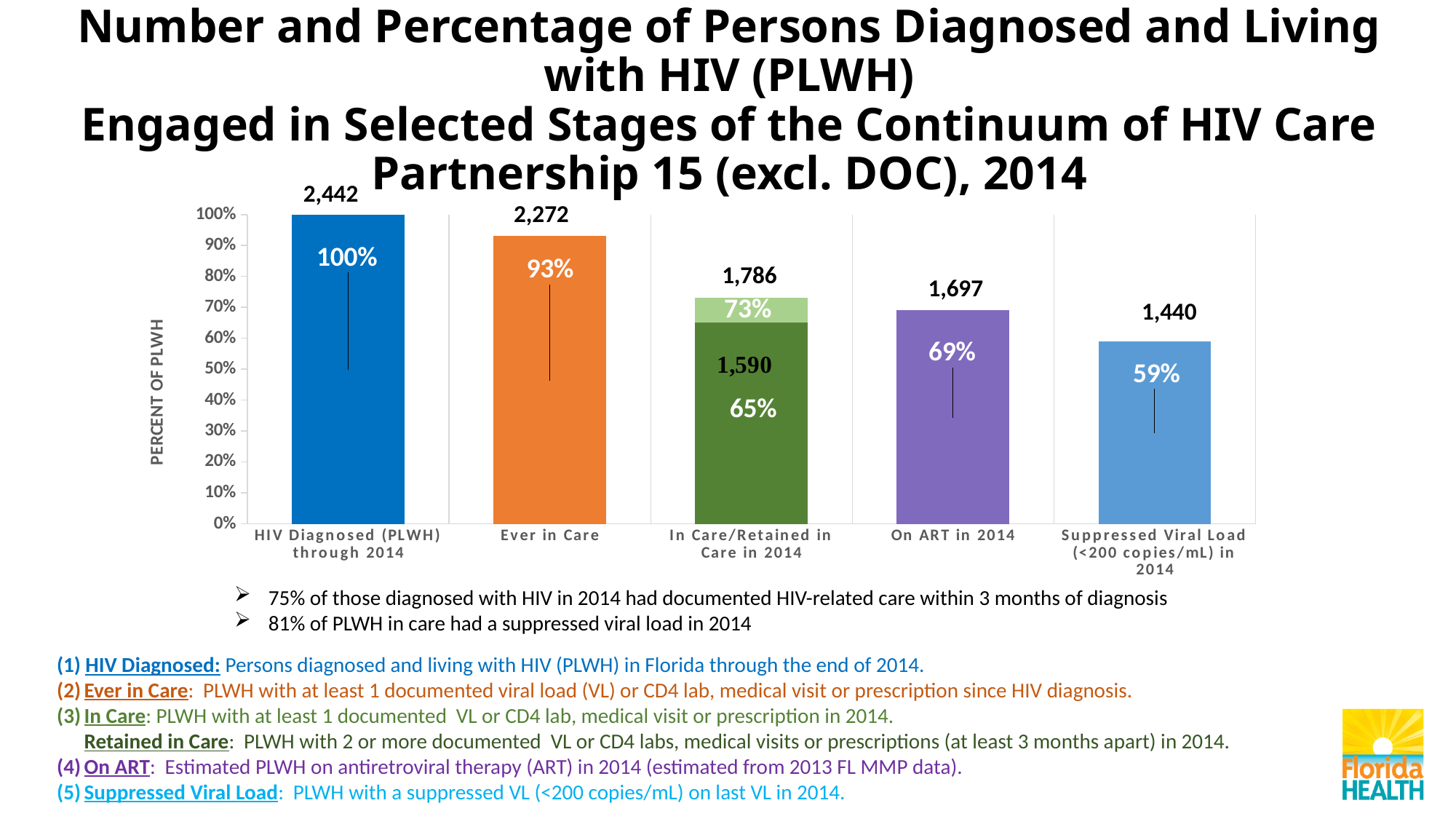
What percentage is shown for 'Suppressed Viral Load (<200 copies/mL) in 2014'? 59% Do the bar heights rise or fall from left to right across the x axis? fall Which category has the highest bar? HIV Diagnosed (PLWH) through 2014 What kind of chart is shown on the slide? bar chart What number is shown above the 'On ART in 2014' bar? 1,697 How many categories are shown on the x axis? 5 Which is larger, the percentage for 'On ART in 2014' or the percentage for 'Suppressed Viral Load (<200 copies/mL) in 2014'? On ART in 2014 What number is shown above the 'HIV Diagnosed (PLWH) through 2014' bar? 2,442 What percentage is shown for 'Ever in Care'? 93% Which category has the lowest bar? Suppressed Viral Load (<200 copies/mL) in 2014 What is the difference between the number for 'Ever in Care' and the number for 'On ART in 2014'? 575 What number is printed inside the dark green portion of the 'In Care/Retained in Care in 2014' bar? 1,590